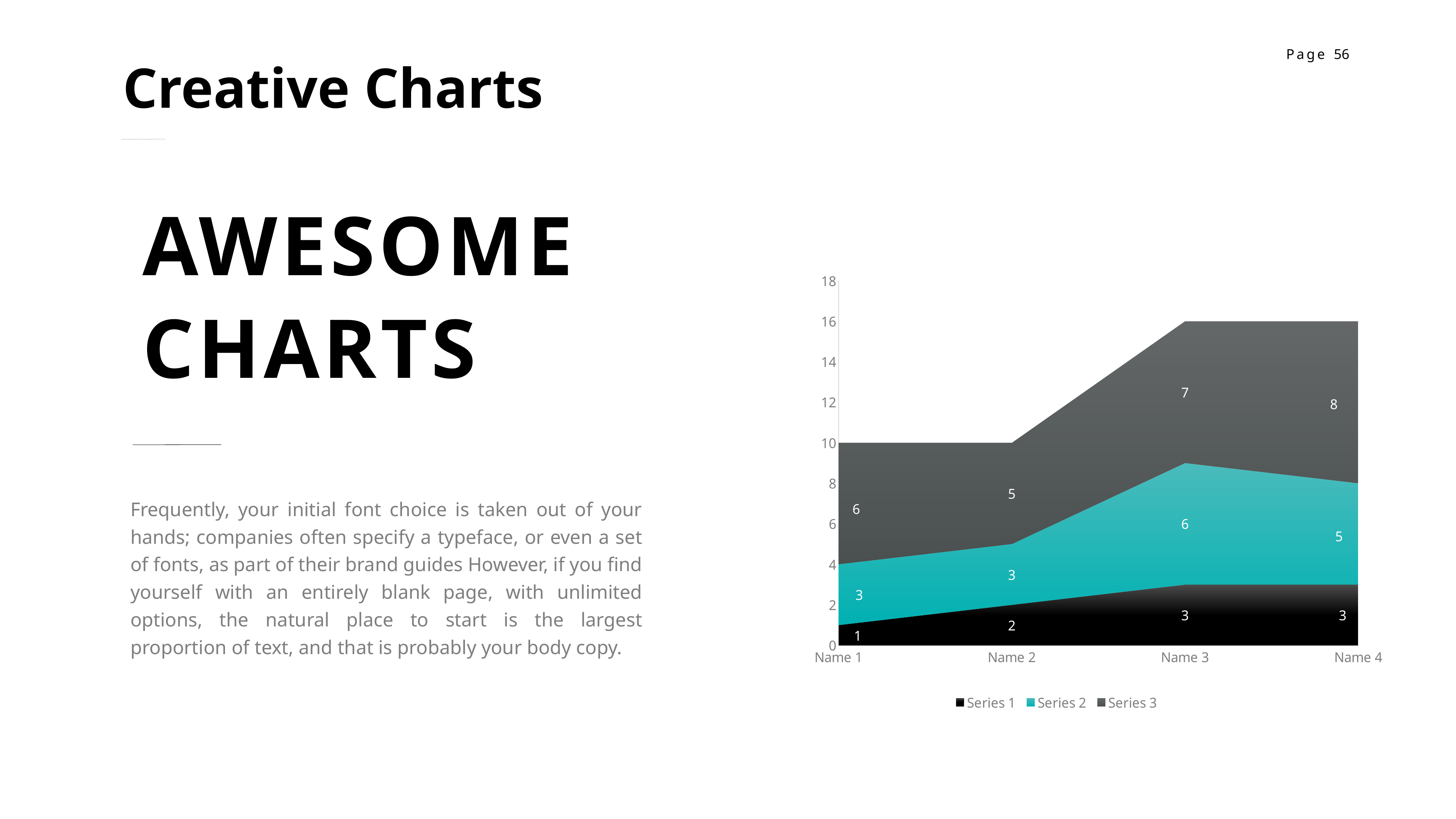
How many categories are shown on the x axis? 4 For which category is Series 1 lowest? Name 1 What is the value of Series 2 for Name 3? 6 What is the total of all three series for Name 3? 16 What is the value of Series 3 for Name 4? 8 What is the value of Series 1 for Name 1? 1 How many series does the legend list? 3 For which category is Series 3 highest? Name 4 What kind of chart is shown on the slide? Stacked area chart What is the difference between the Series 2 values for Name 3 and Name 1? 3 Which series is shown in teal in the legend? Series 2 Which is larger: Series 3 for Name 2 or Series 3 for Name 3? Series 3 for Name 3